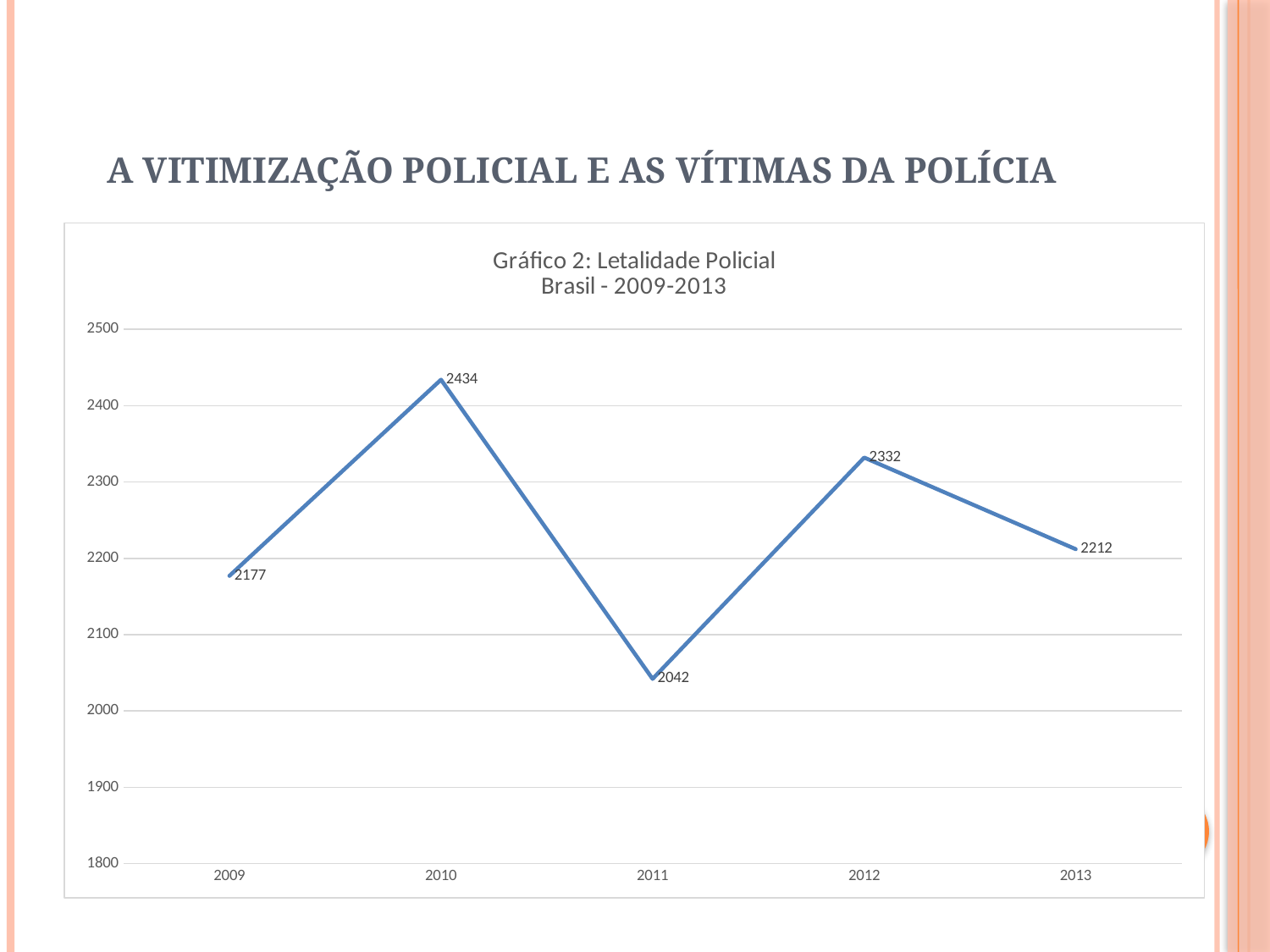
Which year has the lowest value? 2011 What is the title of the chart? Gráfico 2: Letalidade Policial Brasil - 2009-2013 How many years are plotted on the chart? 5 Which is larger, the value for 2009 or the value for 2013? 2013 What is the difference between the values for 2012 and 2013? 120 What is the value for 2010? 2434 What is the value for 2011? 2042 What is the value for 2013? 2212 Which year has the highest value? 2010 Is the value for 2012 greater or less than 2300? greater What kind of chart is shown? line chart What is the difference between the values for 2010 and 2011? 392